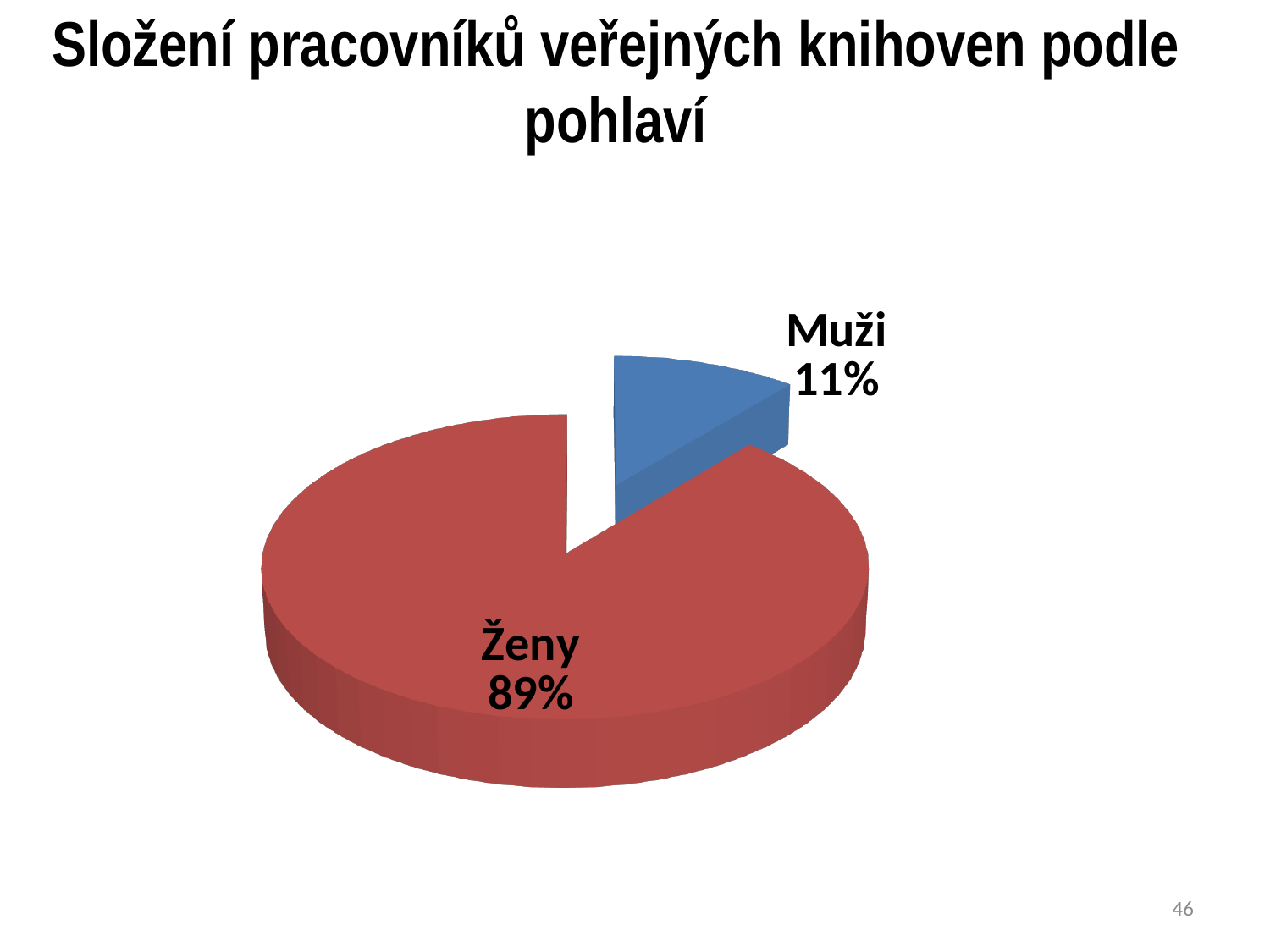
Which category has the smallest slice of the pie? Muži Which category has the largest slice of the pie? Ženy What is the difference in percentage points between the Ženy and Muži slices? 78 What colour is the Muži slice of the pie? Blue What kind of chart is shown on the slide? Pie chart What share of the pie does Ženy represent? 89% Is the share for Ženy greater or less than 50%? greater What is the title of the chart on the slide? Složení pracovníků veřejných knihoven podle pohlaví Which slice is larger, Ženy or Muži? Ženy What share of the pie does Muži represent? 11% How many categories are shown in the pie chart? 2